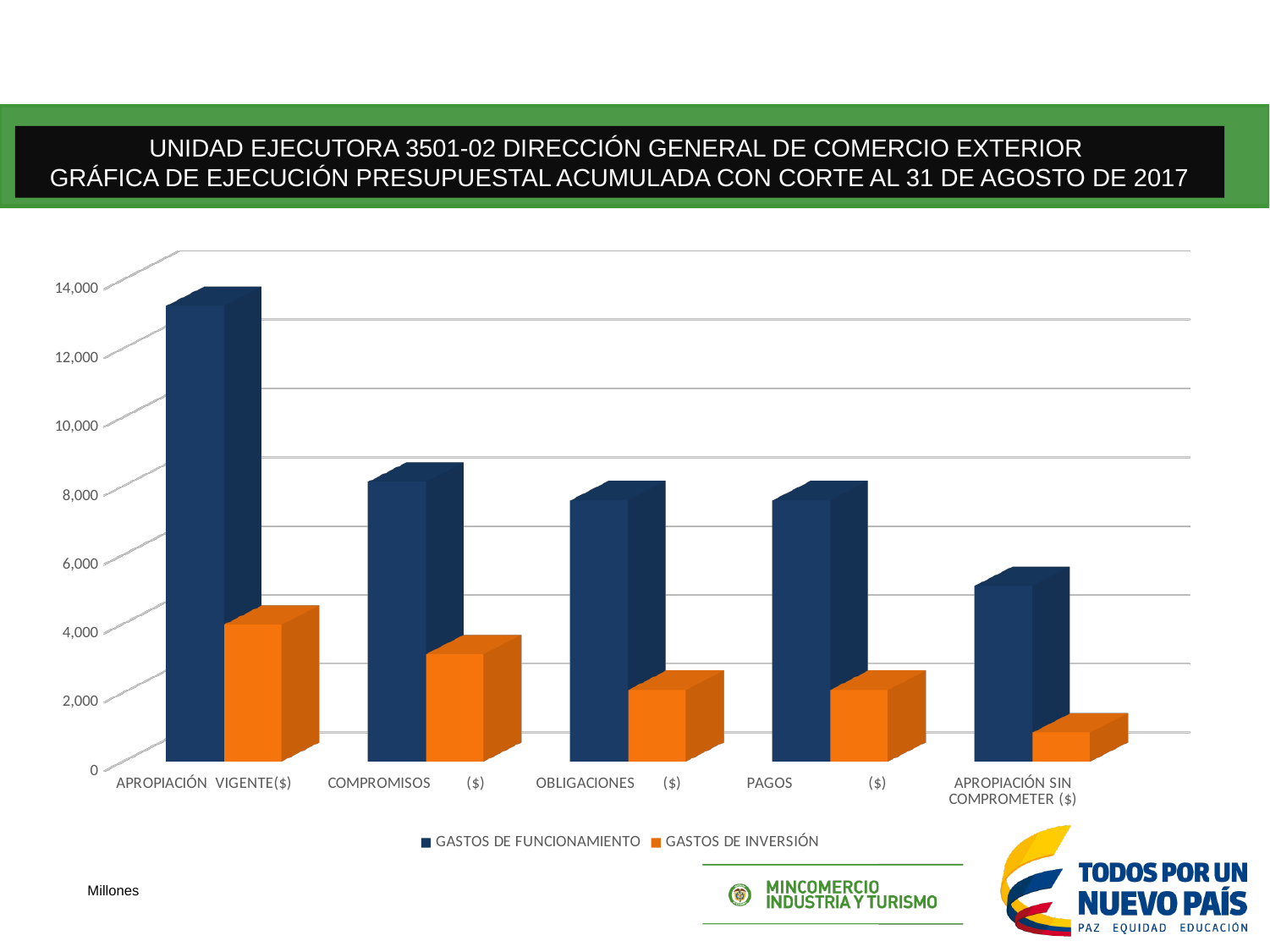
Is the GASTOS DE FUNCIONAMIENTO value for APROPIACIÓN VIGENTE($) greater or less than 12,000? greater Which category has the lowest value for GASTOS DE INVERSIÓN? APROPIACIÓN SIN COMPROMETER ($) Which category has the lowest value for GASTOS DE FUNCIONAMIENTO? APROPIACIÓN SIN COMPROMETER ($) Do the GASTOS DE FUNCIONAMIENTO values generally rise or fall from left to right along the x axis? fall What colour represents GASTOS DE INVERSIÓN in the legend? Orange How many categories are shown on the x axis? 5 For COMPROMISOS ($), which series has the larger value, GASTOS DE FUNCIONAMIENTO or GASTOS DE INVERSIÓN? GASTOS DE FUNCIONAMIENTO Which category has the highest value for GASTOS DE FUNCIONAMIENTO? APROPIACIÓN VIGENTE($) What kind of chart is shown on the slide? Bar chart Is the GASTOS DE INVERSIÓN value for APROPIACIÓN SIN COMPROMETER ($) greater or less than 2,000? less How many series does the legend list? 2